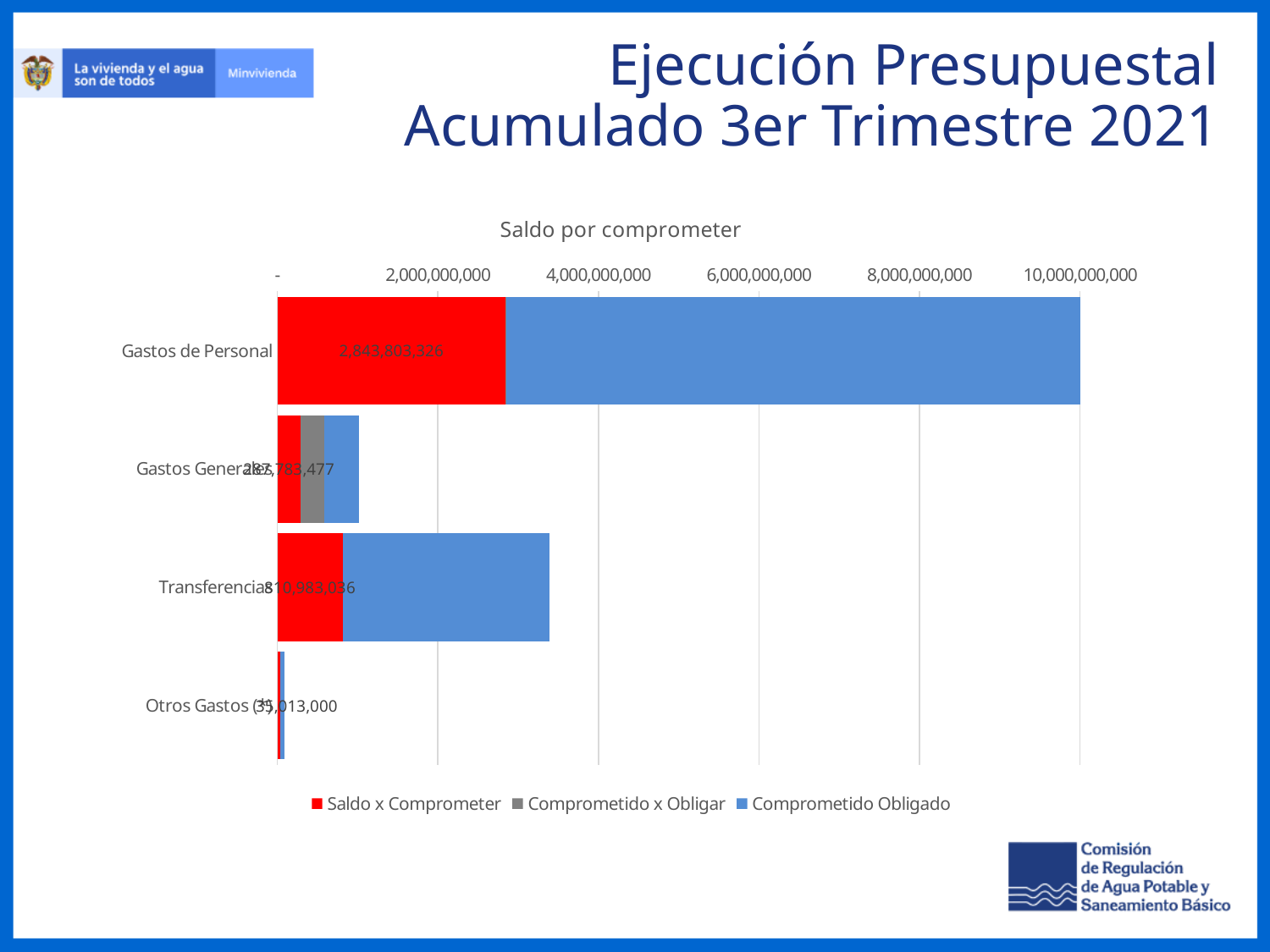
Is the total bar for Gastos de Personal greater or less than 8,000,000,000? greater How many categories are plotted on the chart? 4 Which category has the shortest total bar? Otros Gastos What kind of chart is shown on the slide? bar chart Is the total bar for Gastos Generales greater or less than 2,000,000,000? less What is the title of the chart? Saldo por comprometer Which category has the longest total bar? Gastos de Personal How many series does the legend list? 3 Which has the larger total bar, Gastos Generales or Transferencias? Transferencias What is the Saldo x Comprometer value for Transferencias? 810,983,036 Is the total bar for Transferencias greater or less than 4,000,000,000? less What is the Saldo x Comprometer value for Gastos de Personal? 2,843,803,326